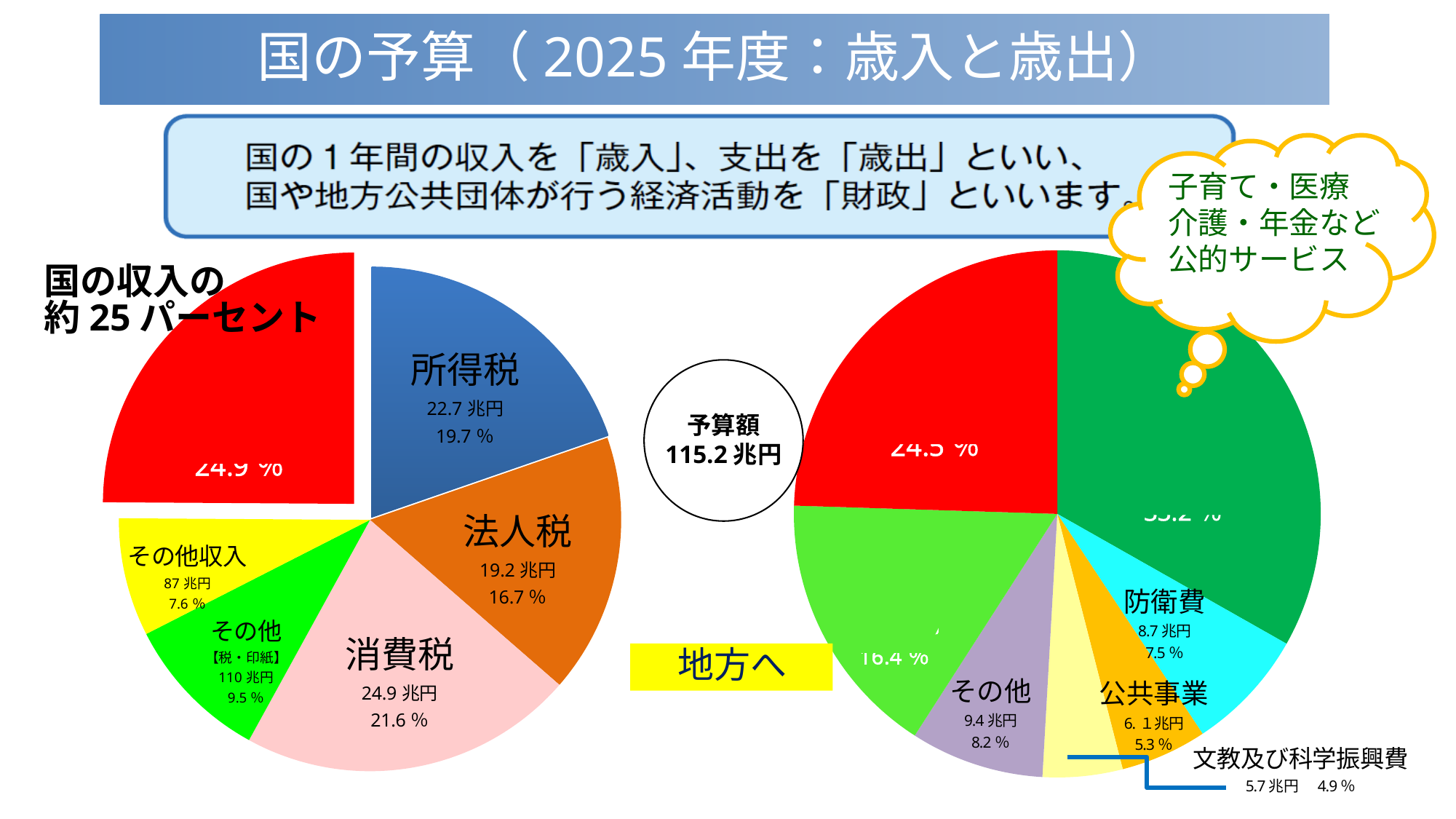
In the left pie chart, what is the difference in 兆円 between 所得税 and 法人税? 3.5 兆円 How many slices does the left pie chart have? 6 What total budget amount (予算額) is shown in the circle between the two pie charts? 115.2 兆円 In the right pie chart, which labeled category has the smallest share? 文教及び科学振興費 In the left pie chart, what is the value shown for 所得税? 22.7 兆円 In the left pie chart, which labeled category has the smallest share? その他収入 In the left pie chart, what percentage is shown for 消費税? 21.6 % In the left pie chart, what percentage is shown for 法人税? 16.7 % What kind of chart is used on the left side of the slide? pie chart In the right pie chart, what is the value shown for 防衛費? 8.7 兆円 In the left pie chart, which is larger, 所得税 or 消費税? 消費税 In the right pie chart, what percentage is shown for 公共事業? 5.3 %